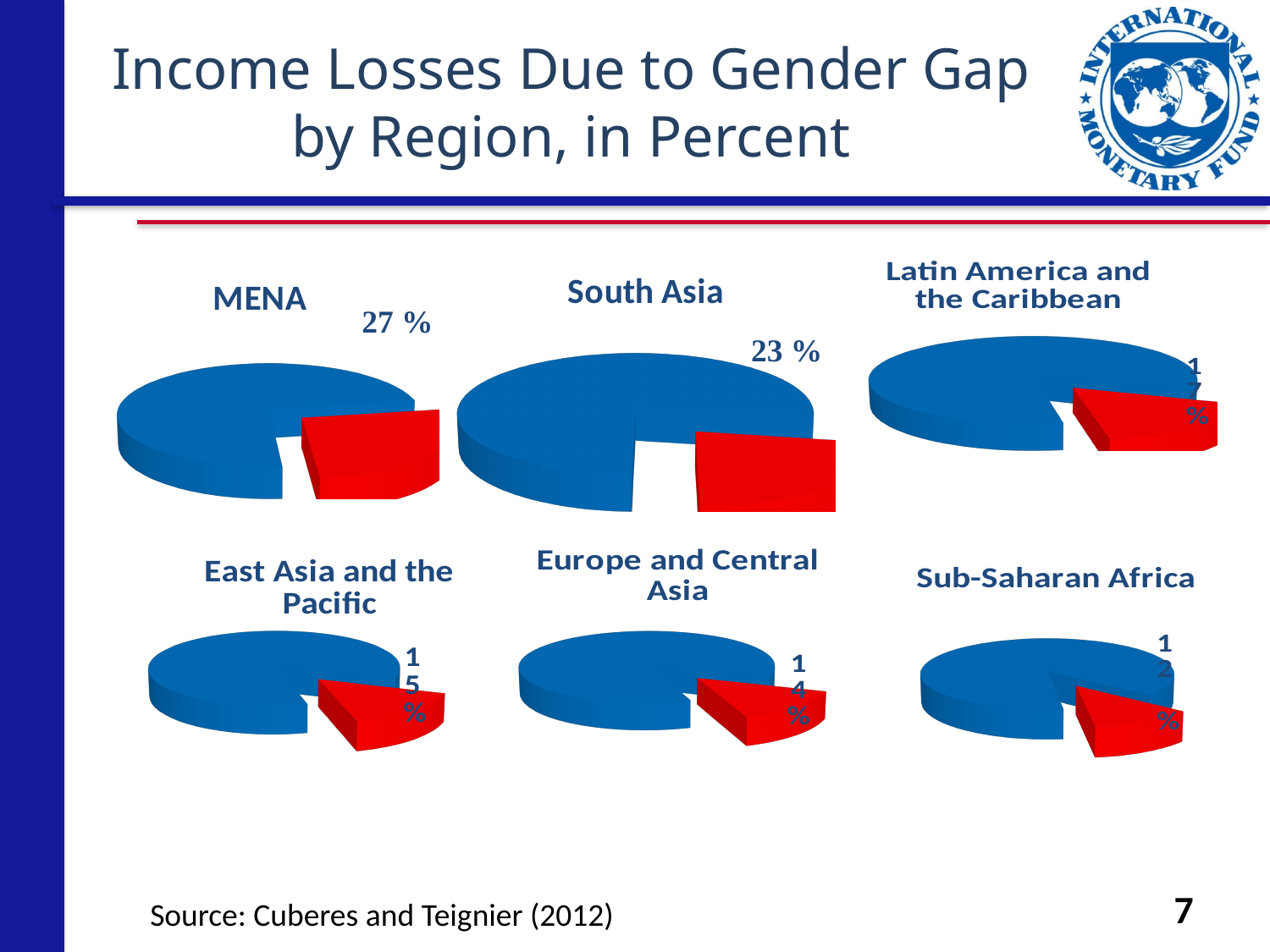
In the MENA pie chart, what is the value shown for the red slice? 27 % Across the six pie charts, which region shows the lowest income loss percentage? Sub-Saharan Africa In the South Asia pie chart, what percentage is labelled on the red slice? 23 % Across the six pie charts, which region shows the highest income loss percentage? MENA In the Latin America and the Caribbean pie chart, what percentage is labelled on the red slice? 17 % Comparing the MENA and South Asia pie charts, which region has the larger labelled percentage? MENA How many pie charts are shown on the slide? 6 What is the difference between the labelled percentage in the MENA pie chart and the labelled percentage in the Sub-Saharan Africa pie chart? 15 % In the East Asia and the Pacific pie chart, what percentage is labelled on the red slice? 15 % In the Europe and Central Asia pie chart, what percentage is labelled on the red slice? 14 % In the Sub-Saharan Africa pie chart, what percentage is labelled on the red slice? 12 % What type of chart is used for each region on the slide? Pie chart